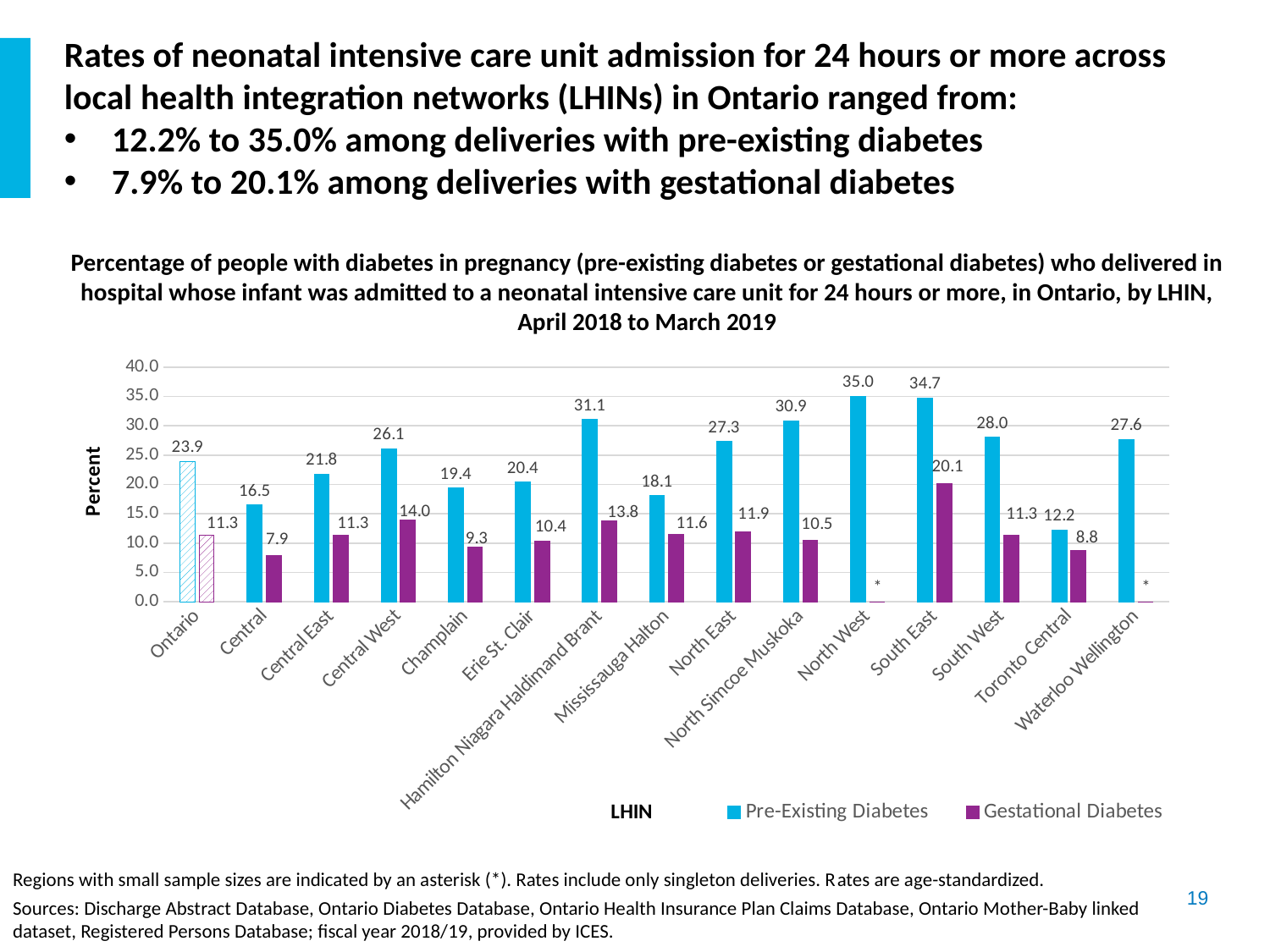
Which is larger, the Pre-Existing Diabetes value for South East or for South West? South East How many series does the legend list? 2 What is the Gestational Diabetes value for South East? 20.1 What is the Pre-Existing Diabetes value for North West? 35.0 What is the difference between the Pre-Existing Diabetes and Gestational Diabetes values for Ontario? 12.6 Which LHIN has the lowest Pre-Existing Diabetes value? Toronto Central Which LHIN has the highest Pre-Existing Diabetes value? North West Is the Pre-Existing Diabetes value for Central West greater or less than 25.0? greater What is the Pre-Existing Diabetes value for Hamilton Niagara Haldimand Brant? 31.1 Which LHIN has the lowest Gestational Diabetes value among those with a printed value? Central What kind of chart is shown on the slide? Bar chart How many LHIN categories are shown on the x axis? 15